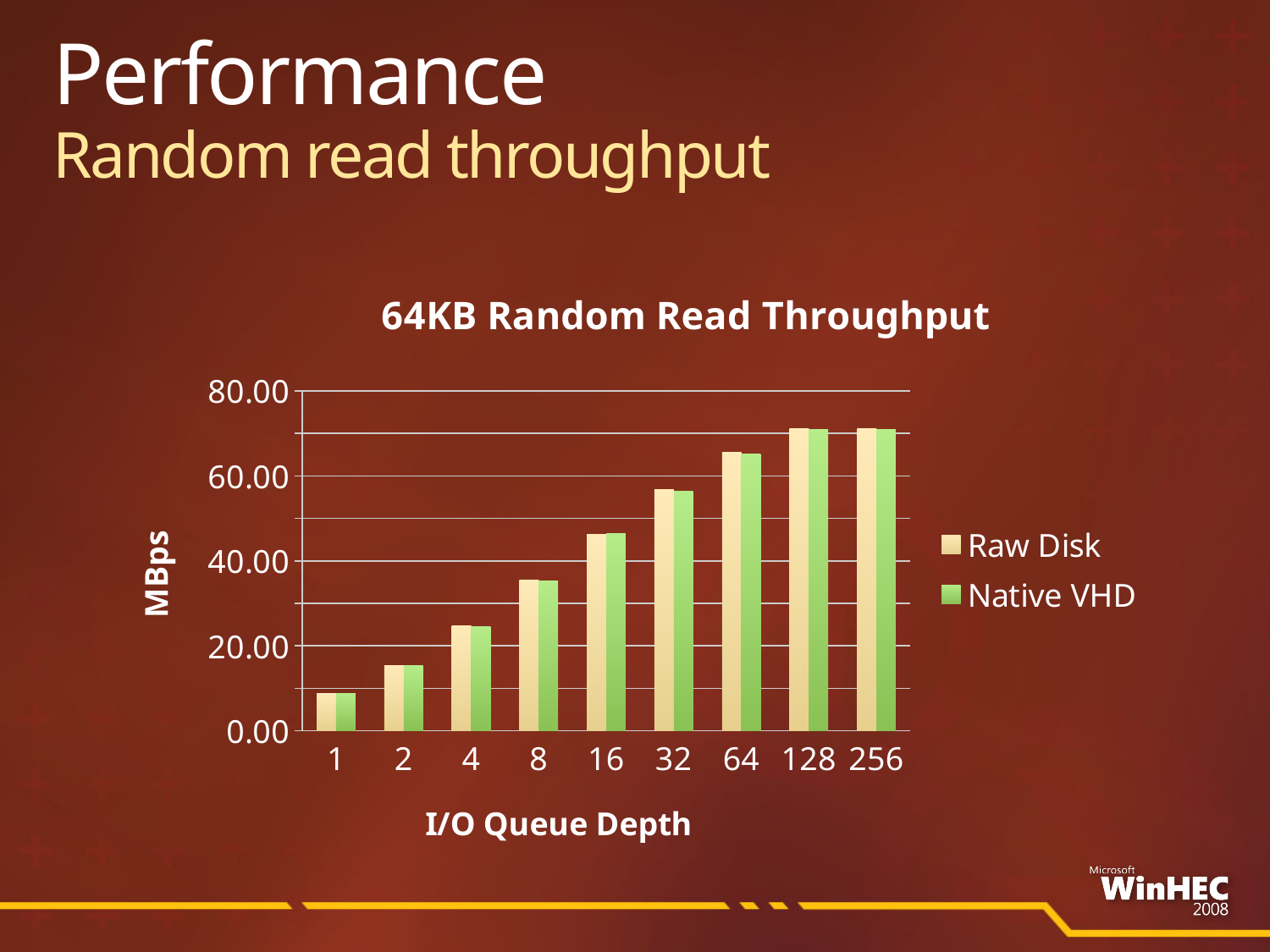
What kind of chart is shown on the slide? bar chart How many I/O queue depth categories are plotted on the x axis? 9 Which is larger: the Raw Disk value at I/O queue depth 32 or at I/O queue depth 4? 32 Is the Raw Disk value at I/O queue depth 64 greater or less than 60.00? greater Is the Native VHD value at I/O queue depth 2 greater or less than 20.00? less Is the Native VHD value at I/O queue depth 8 greater or less than 40.00? less Which I/O queue depth has the lowest Raw Disk throughput? 1 What is the title of the chart? 64KB Random Read Throughput How many series does the legend list? 2 Do the Native VHD values rise or fall as I/O queue depth increases along the x axis? rise What is the label of the y axis? MBps